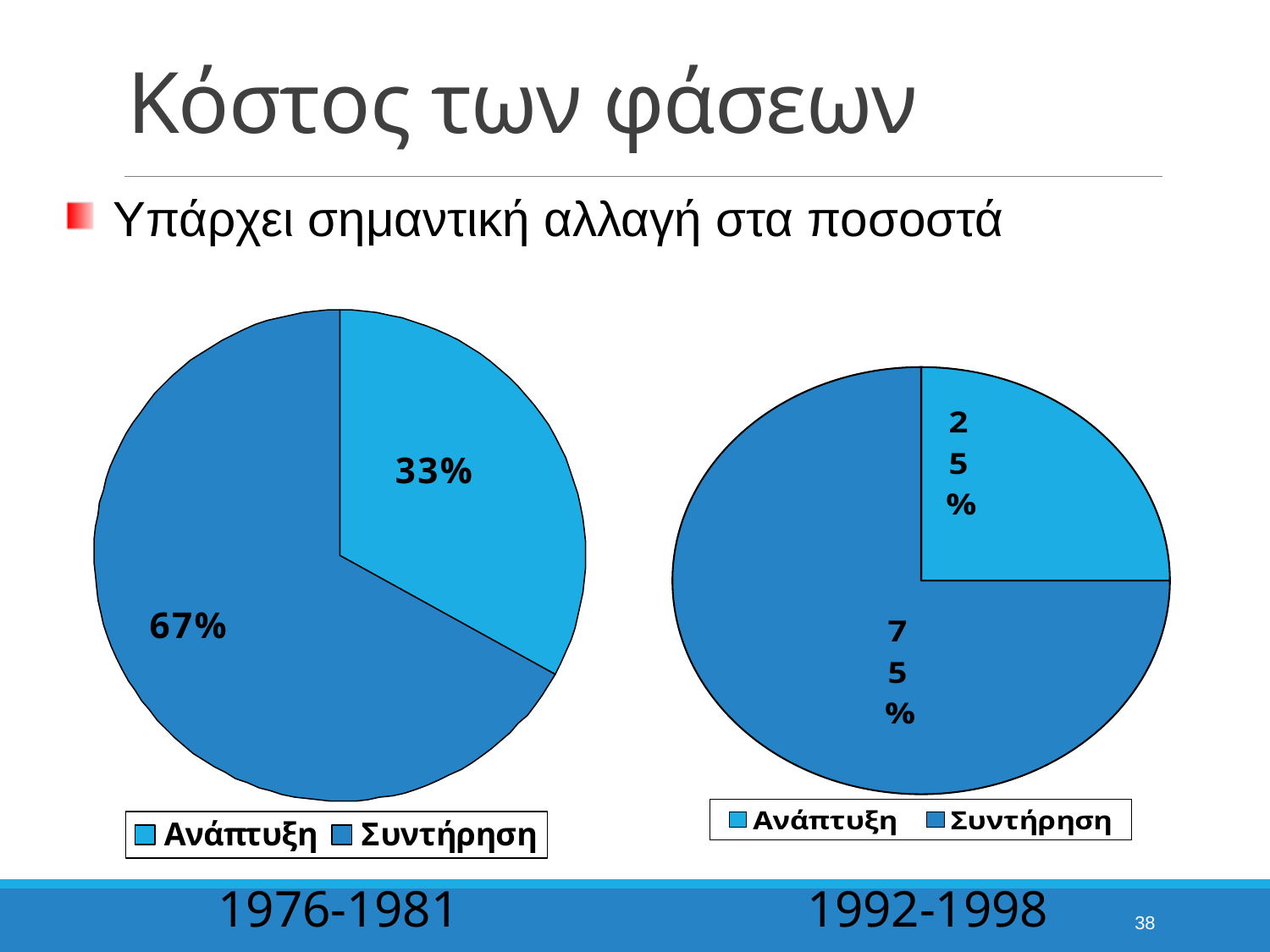
In the left pie chart (1976-1981), what share does Συντήρηση have? 67% In the right pie chart (1992-1998), what is the difference between the Συντήρηση and Ανάπτυξη shares? 50% How many slices does the right pie chart (1992-1998) have? 2 In the left pie chart (1976-1981), which slice is the largest? Συντήρηση In the right pie chart (1992-1998), what share does Ανάπτυξη have? 25% Which chart shows a larger share for Ανάπτυξη, the left (1976-1981) or the right (1992-1998)? left (1976-1981) In the left pie chart (1976-1981), what is the difference between the Συντήρηση and Ανάπτυξη shares? 34% How many entries does the legend of the left pie chart list? 2 In the right pie chart (1992-1998), what share does Συντήρηση have? 75% What type of chart is used on the left of the slide? pie chart In the right pie chart (1992-1998), which slice is the smallest? Ανάπτυξη